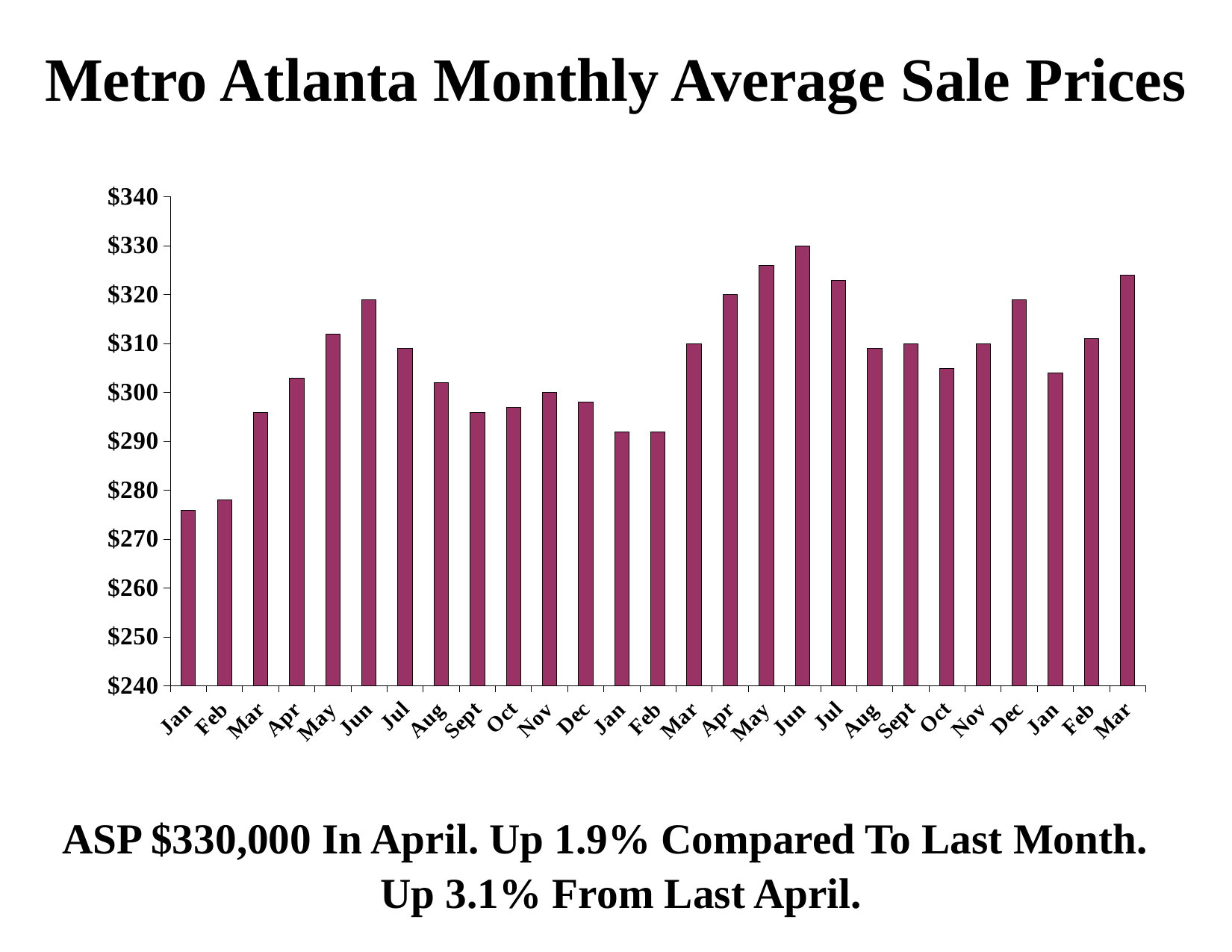
What is the lowest value shown on the vertical axis? $240 Do the values rise or fall from the first Jan through the first Jun? rise Is the value for the first Jan bar greater or less than $280? less Is the value for the first-year Sept bar greater or less than $300? less Which is larger, the first-year Jun bar or the first-year Jul bar? Jun Which month has the lowest average sale price in the chart? Jan (first year) How many bars (months) are plotted in the chart? 27 What is the title of the chart? Metro Atlanta Monthly Average Sale Prices Is the value for the final Mar bar greater or less than $320? greater Which month has the highest average sale price in the chart? Jun (second year) What type of chart is shown on the slide? bar chart